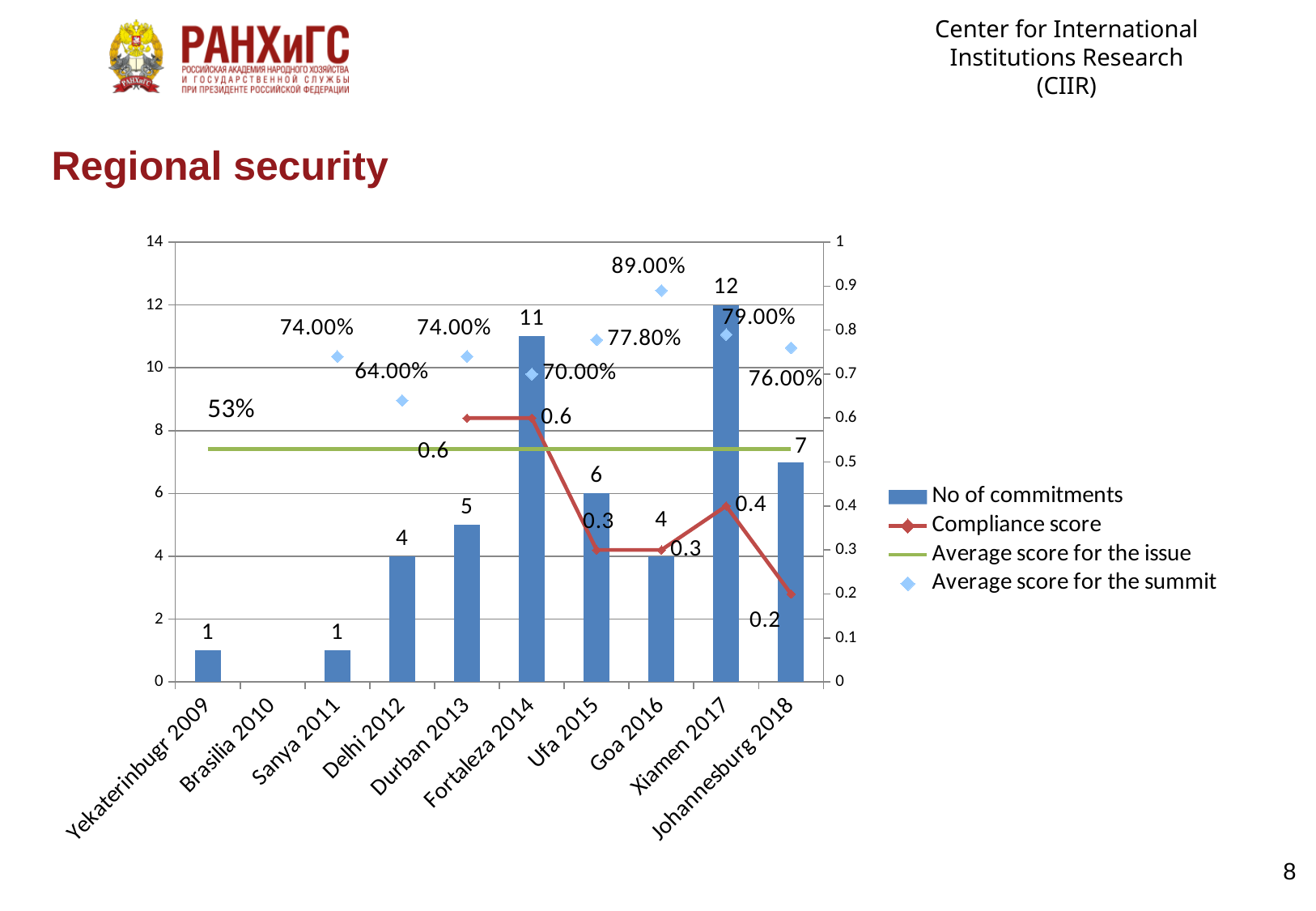
What is the difference in the number of commitments between Fortaleza 2014 and Ufa 2015? 5 Which summit has the highest number of commitments? Xiamen 2017 What is the compliance score for Johannesburg 2018? 0.2 Does the compliance score rise or fall from Fortaleza 2014 to Ufa 2015? fall Which summit has the highest average score for the summit? Goa 2016 How many commitments are shown for Xiamen 2017? 12 How many summits are listed on the x axis? 10 How many series does the legend list? 4 Which summit has the lowest average score for the summit? Delhi 2012 What is the average score for the issue shown by the green line? 53% What is the average score for the summit at Goa 2016? 89.00% Which has more commitments, Delhi 2012 or Durban 2013? Durban 2013